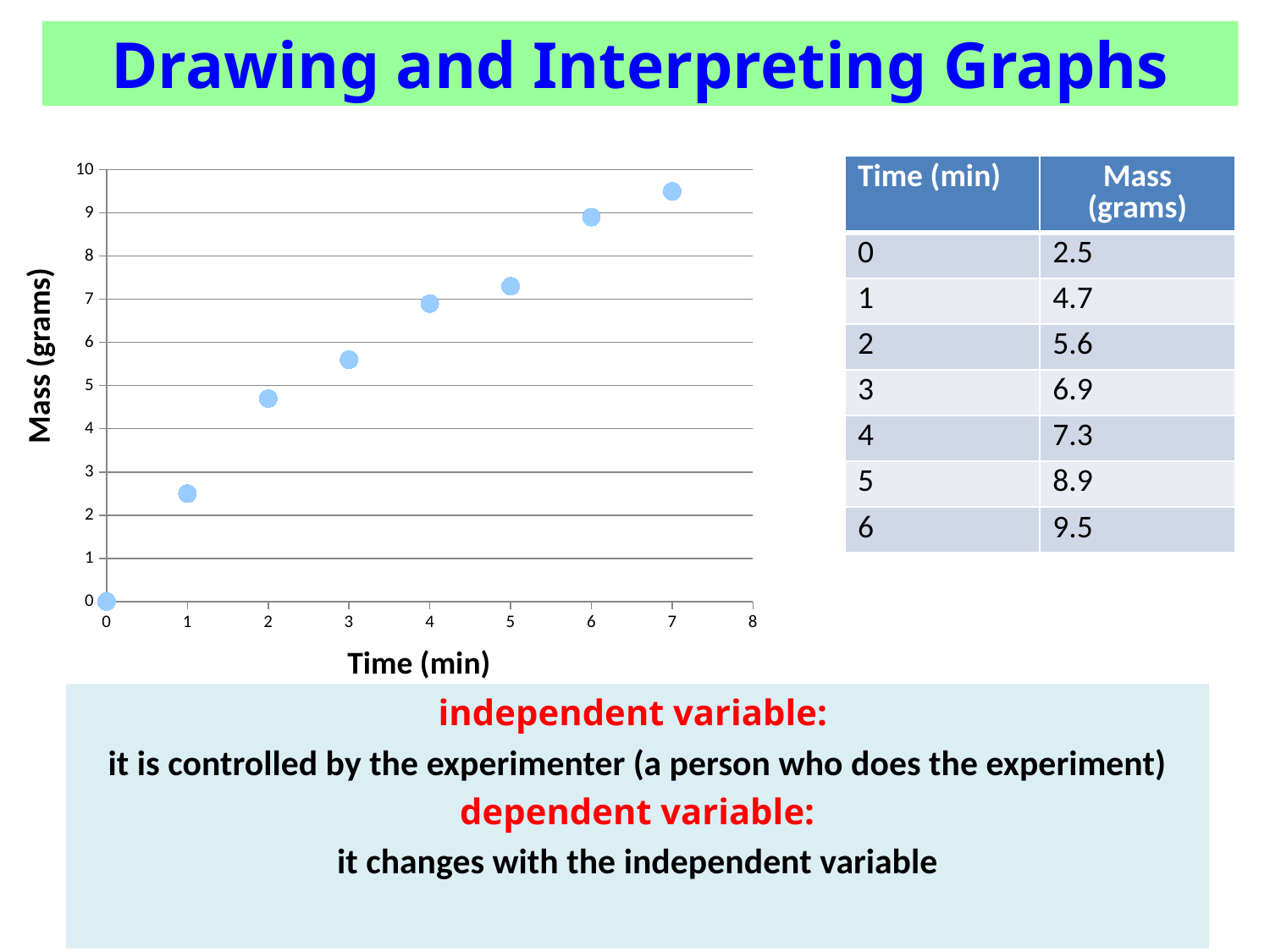
Is the plotted mass at time 3 min greater or less than 5 grams? greater What kind of chart is shown on the slide? scatter chart Which has the larger plotted mass: time 3 min or time 6 min? time 6 min At which time (min) is the plotted mass highest? 7 What is the plotted mass value at time 0 min? 0 Do the plotted values rise or fall as time increases along the x axis? rise At which time (min) is the plotted mass lowest? 0 What is the label on the horizontal axis of the chart? Time (min) Is the plotted mass at time 7 min greater or less than 9 grams? greater Is the plotted mass at time 1 min greater or less than 3 grams? less How many data points are plotted on the chart? 8 What is the label on the vertical axis of the chart? Mass (grams)